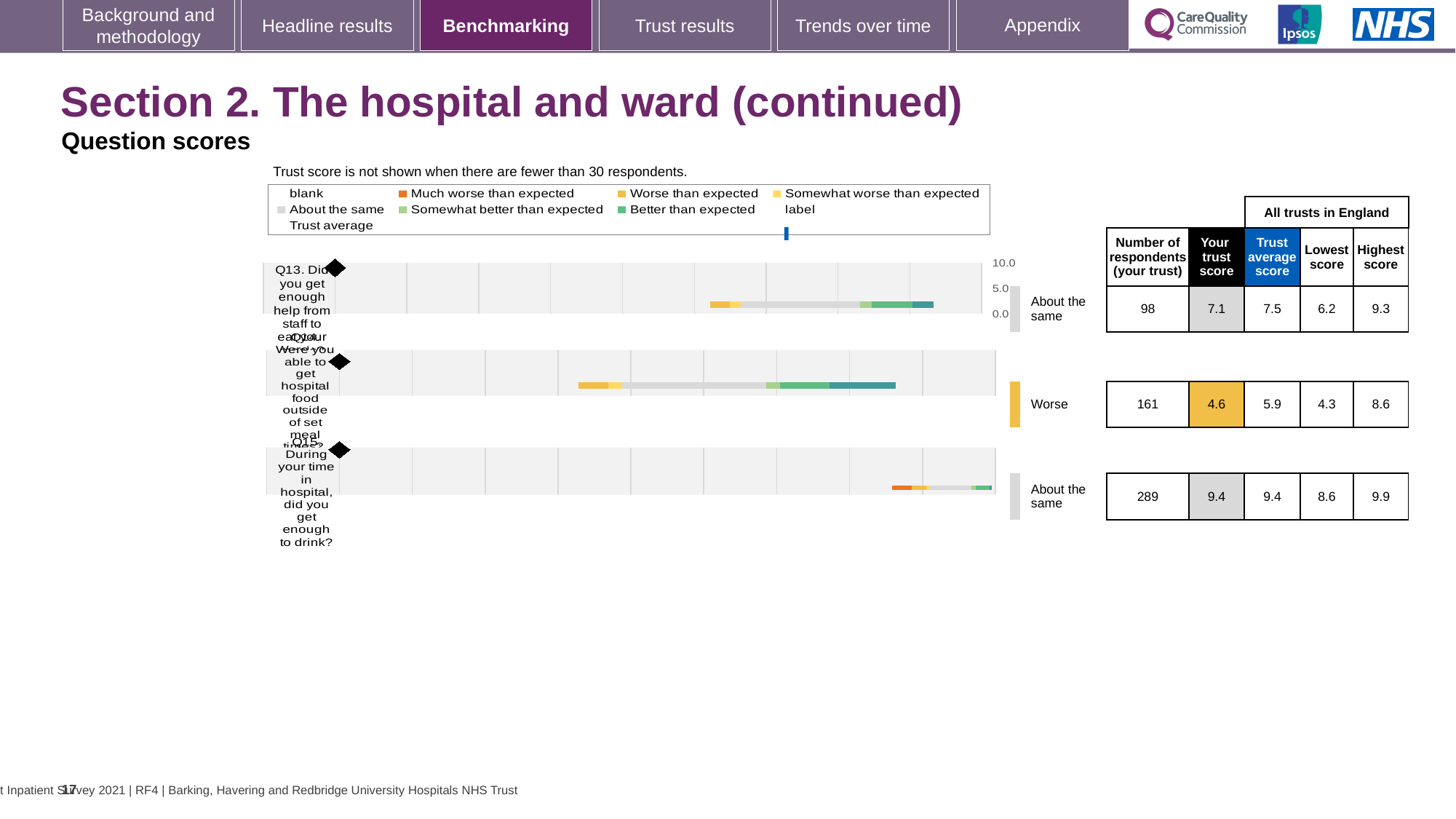
How many respondents answered Q15 (did you get enough to drink?) at this trust? 289 What is the trust score for Q14 (Were you able to get hospital food outside of set meal times?)? 4.6 For Q14, how much lower is the trust score than the trust average score? 1.3 What kind of chart is used to show the question scores for Q13, Q14 and Q15? bar chart What is the trust score for Q13 (Did you get enough help from staff to eat your meals?)? 7.1 What is the highest score across all trusts in England for Q15? 9.9 For Q13, which is larger: the trust score or the trust average score? Trust average score How many questions are plotted in the benchmarking charts on this slide? 3 What benchmark category is shown for Q14? Worse Which question has the highest trust score on this slide? Q15 Which question has the lowest trust score on this slide? Q14 For Q13, what is the difference between the highest score and the lowest score across all trusts in England? 3.1